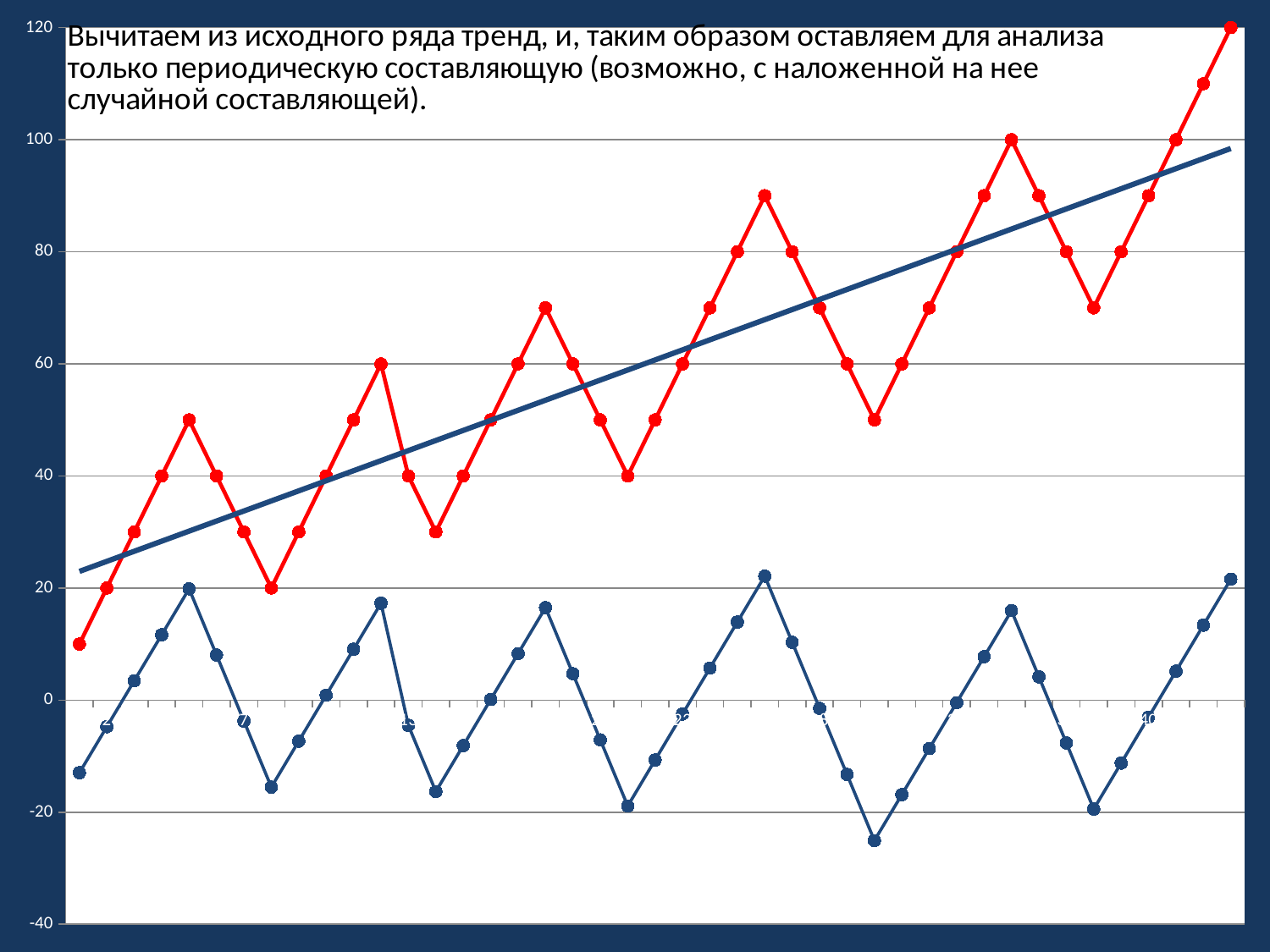
What kind of chart is shown on the slide? line chart Which line reaches higher values, the red line or the blue line with markers? the red line How many lines are plotted on the chart? 3 Is the lowest value of the blue line with markers greater or less than -20? less Is the first point of the red line greater or less than 20? less Does the straight dark blue trend line rise or fall from left to right? rise Does the red line rise or fall overall from left to right? rise At the right end of the chart, which is higher: the red line or the straight trend line? the red line What colour is the line whose values oscillate around 0? dark blue Is the last point of the red line greater or less than 100? greater What is the highest value reached by the red line? 120